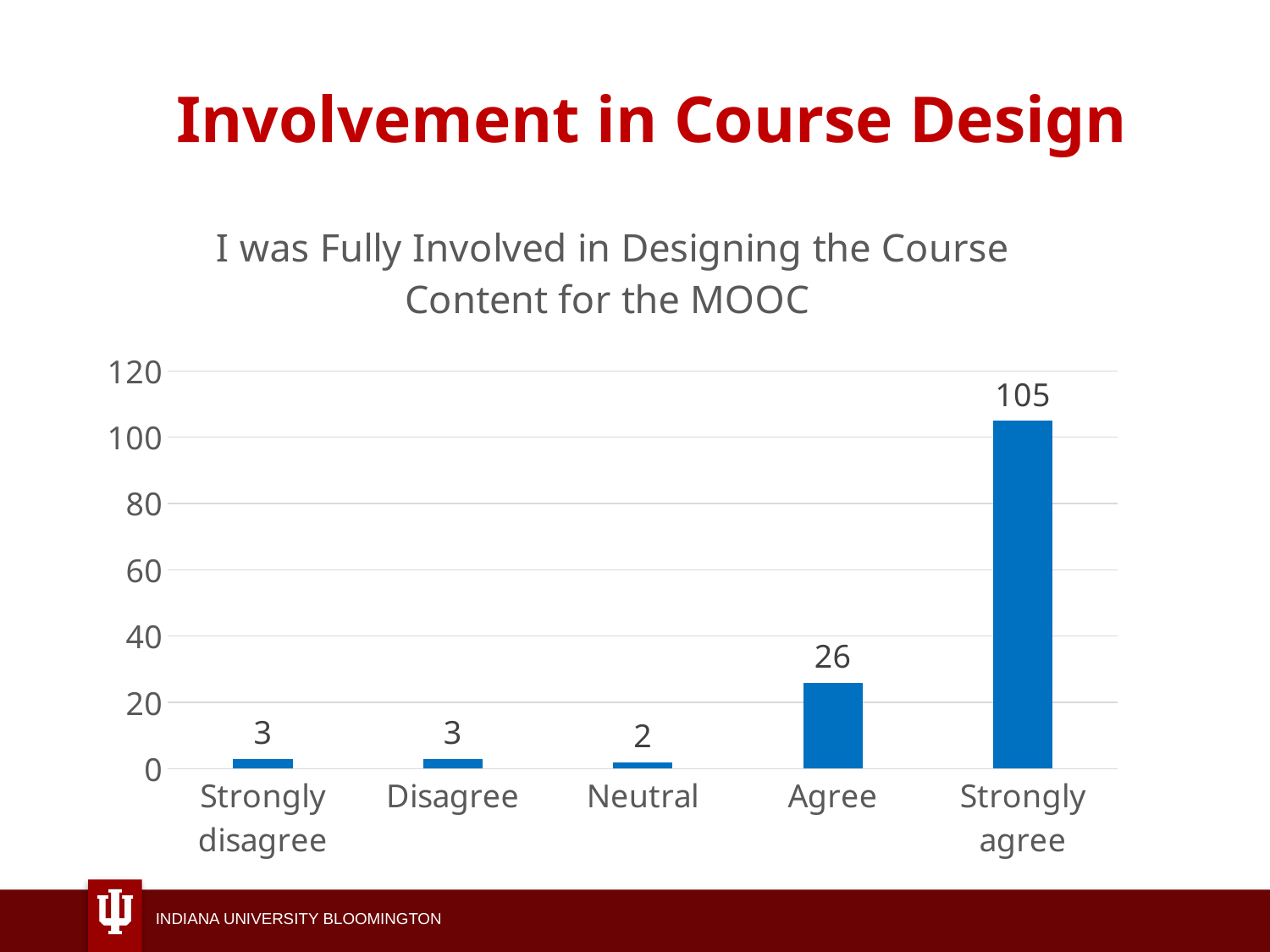
Which category has the highest value? Strongly agree What is the value for Strongly disagree? 3 What is the value for Agree? 26 How many categories are shown on the x axis? 5 What kind of chart is shown on the slide? bar chart Which is larger, the value for Agree or the value for Disagree? Agree What is the title of the chart? I was Fully Involved in Designing the Course Content for the MOOC What is the difference between the values for Strongly agree and Agree? 79 Which category has the lowest value? Neutral Is the value for Strongly agree greater or less than 100? greater What is the value for Strongly agree? 105 What is the value for Neutral? 2